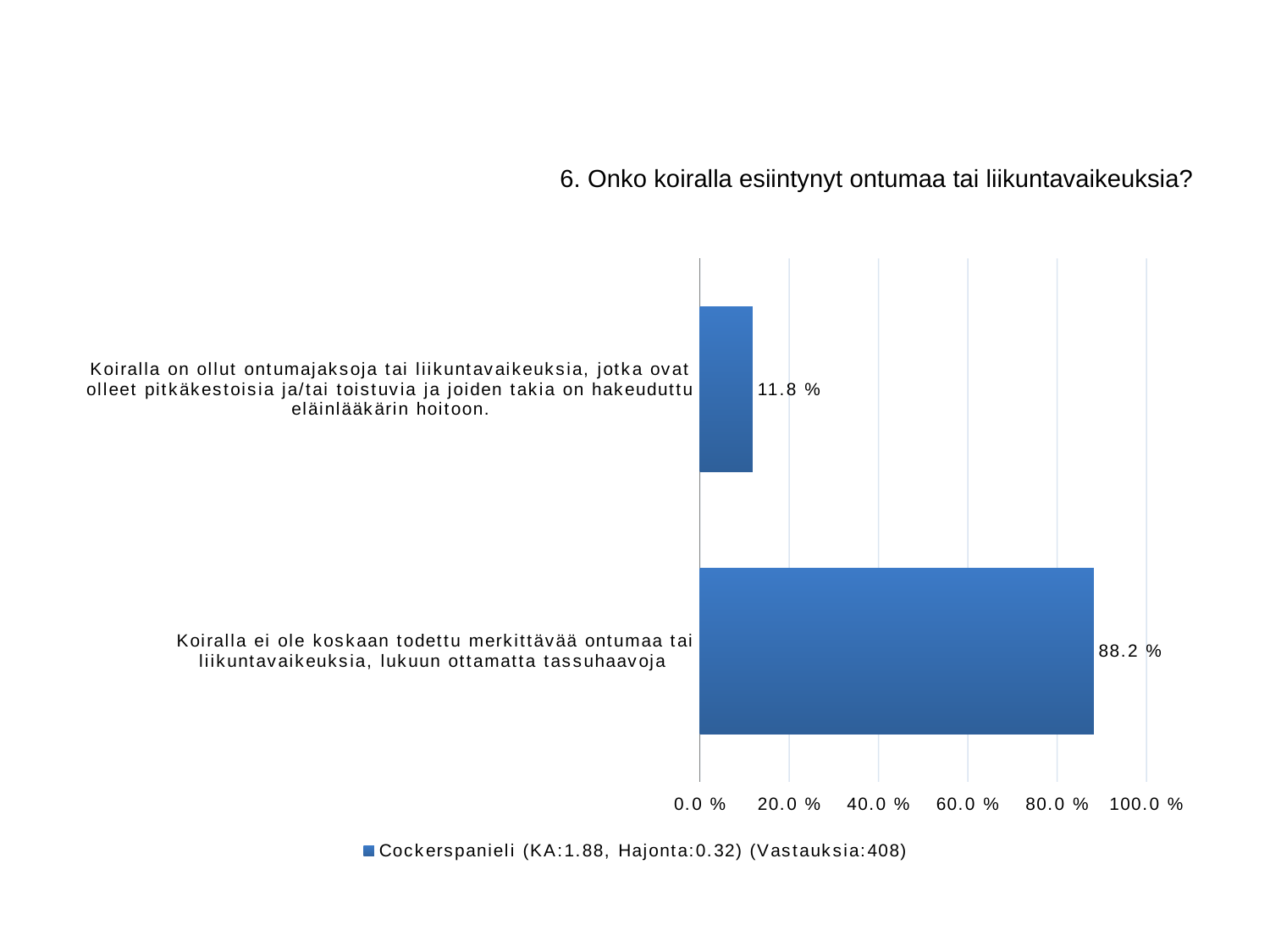
Which category has the highest value? Koiralla ei ole koskaan todettu merkittävää ontumaa tai liikuntavaikeuksia, lukuun ottamatta tassuhaavoja Is the value for 'Koiralla ei ole koskaan todettu merkittävää ontumaa tai liikuntavaikeuksia, lukuun ottamatta tassuhaavoja' greater or less than 80.0 %? greater What is the title of the chart? 6. Onko koiralla esiintynyt ontumaa tai liikuntavaikeuksia? What kind of chart is shown on the slide? Bar chart What is the difference between the two plotted values? 76.4 % How many categories are plotted in the chart? 2 What is the value for the category 'Koiralla on ollut ontumajaksoja tai liikuntavaikeuksia, jotka ovat olleet pitkäkestoisia ja/tai toistuvia ja joiden takia on hakeuduttu eläinlääkärin hoitoon.'? 11.8 % What is the value for the category 'Koiralla ei ole koskaan todettu merkittävää ontumaa tai liikuntavaikeuksia, lukuun ottamatta tassuhaavoja'? 88.2 % Which category has the lowest value? Koiralla on ollut ontumajaksoja tai liikuntavaikeuksia, jotka ovat olleet pitkäkestoisia ja/tai toistuvia ja joiden takia on hakeuduttu eläinlääkärin hoitoon. Which is larger: the value for dogs that have never had significant lameness, or the value for dogs that have had prolonged or recurring lameness? Dogs that have never had significant lameness (88.2 %) Is the value for 'Koiralla on ollut ontumajaksoja tai liikuntavaikeuksia...' greater or less than 20.0 %? less How many series does the legend list? 1